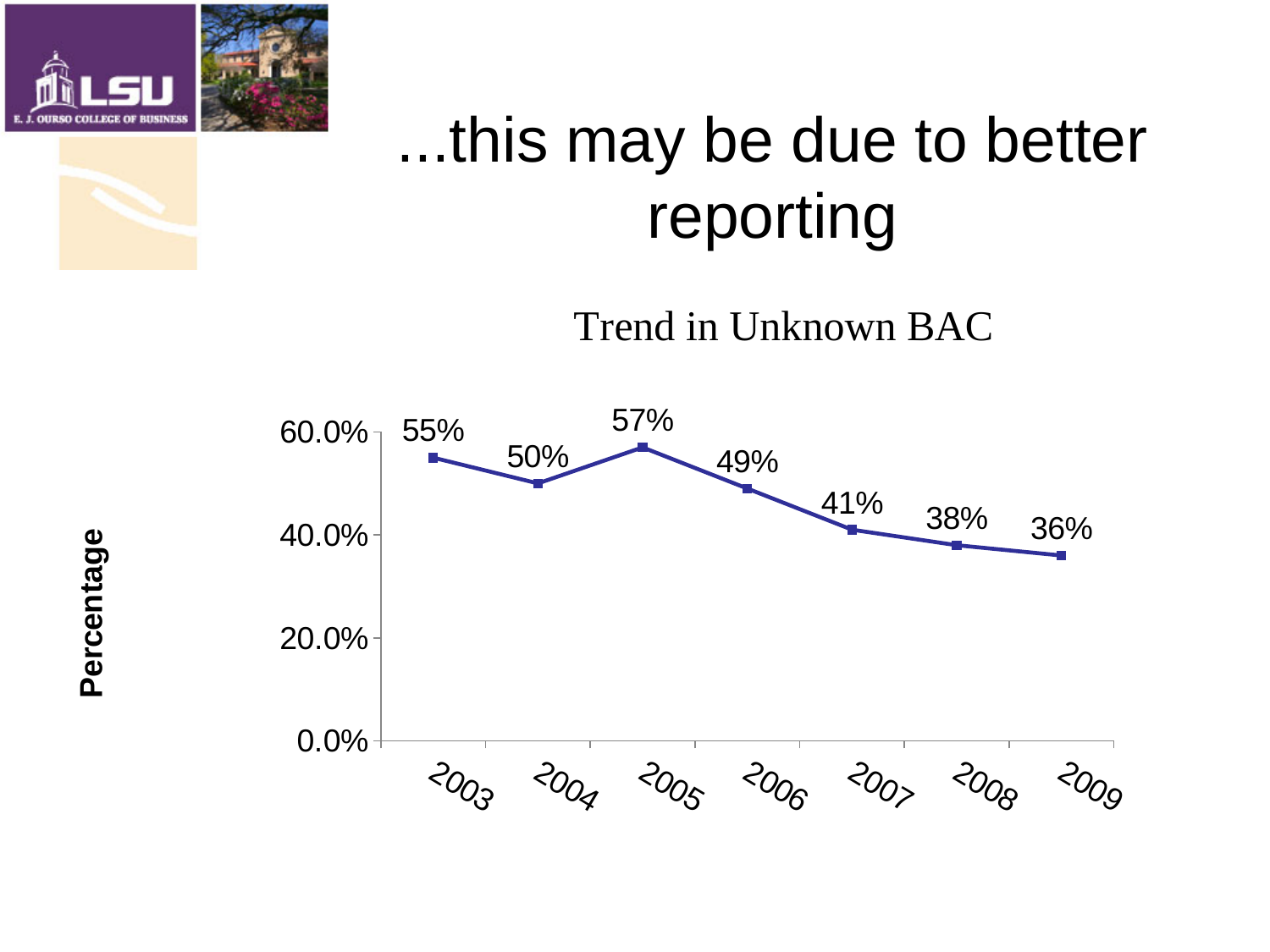
What is the value for 2006? 49% What kind of chart is shown? line chart Which year has the lowest value? 2009 Which year has the highest value? 2005 Is the value for 2008 greater or less than 40.0%? less How many years are plotted on the chart? 7 What is the difference between the values for 2005 and 2009? 21% What is the value for 2009? 36% What is the value for 2003? 55% Do the values generally rise or fall from 2005 to 2009? fall Which is larger, the value for 2004 or the value for 2007? 2004 What is the title of the chart? Trend in Unknown BAC